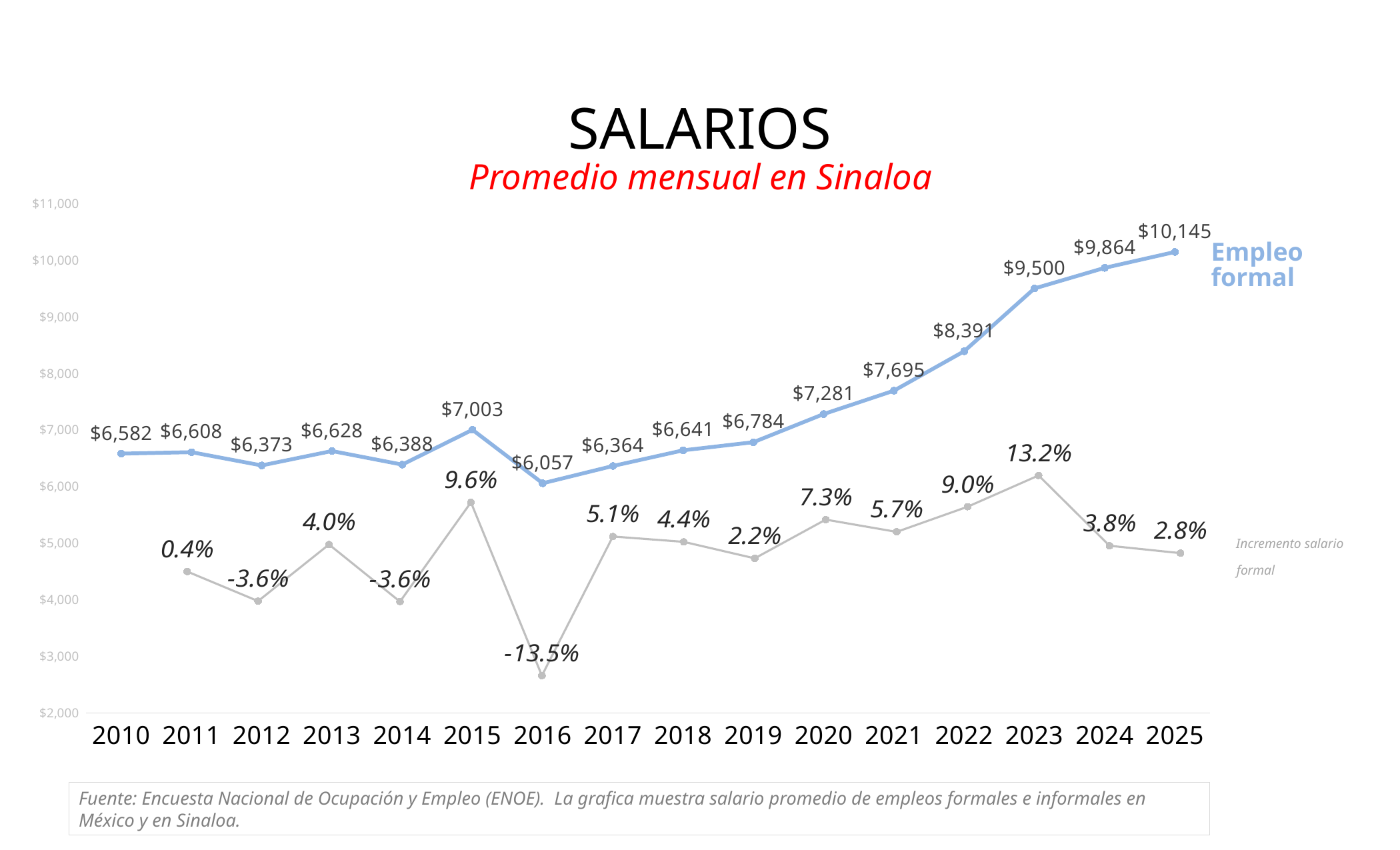
What is the Incremento salario formal value for 2023? 13.2% What type of chart is shown on the slide? Line chart Which is larger, the Empleo formal salary in 2015 or in 2020? 2020 Which year has the lowest Empleo formal salary? 2016 What is the Empleo formal average monthly salary for 2016? $6,057 What is the Incremento salario formal value for 2016? -13.5% How many years are shown on the x axis? 16 What is the subtitle of the chart shown in red? Promedio mensual en Sinaloa What is the difference between the Empleo formal salary in 2025 and in 2010? $3,563 Which year has the lowest Incremento salario formal value? 2016 What is the Empleo formal average monthly salary for 2022? $8,391 Which year has the highest Empleo formal salary? 2025